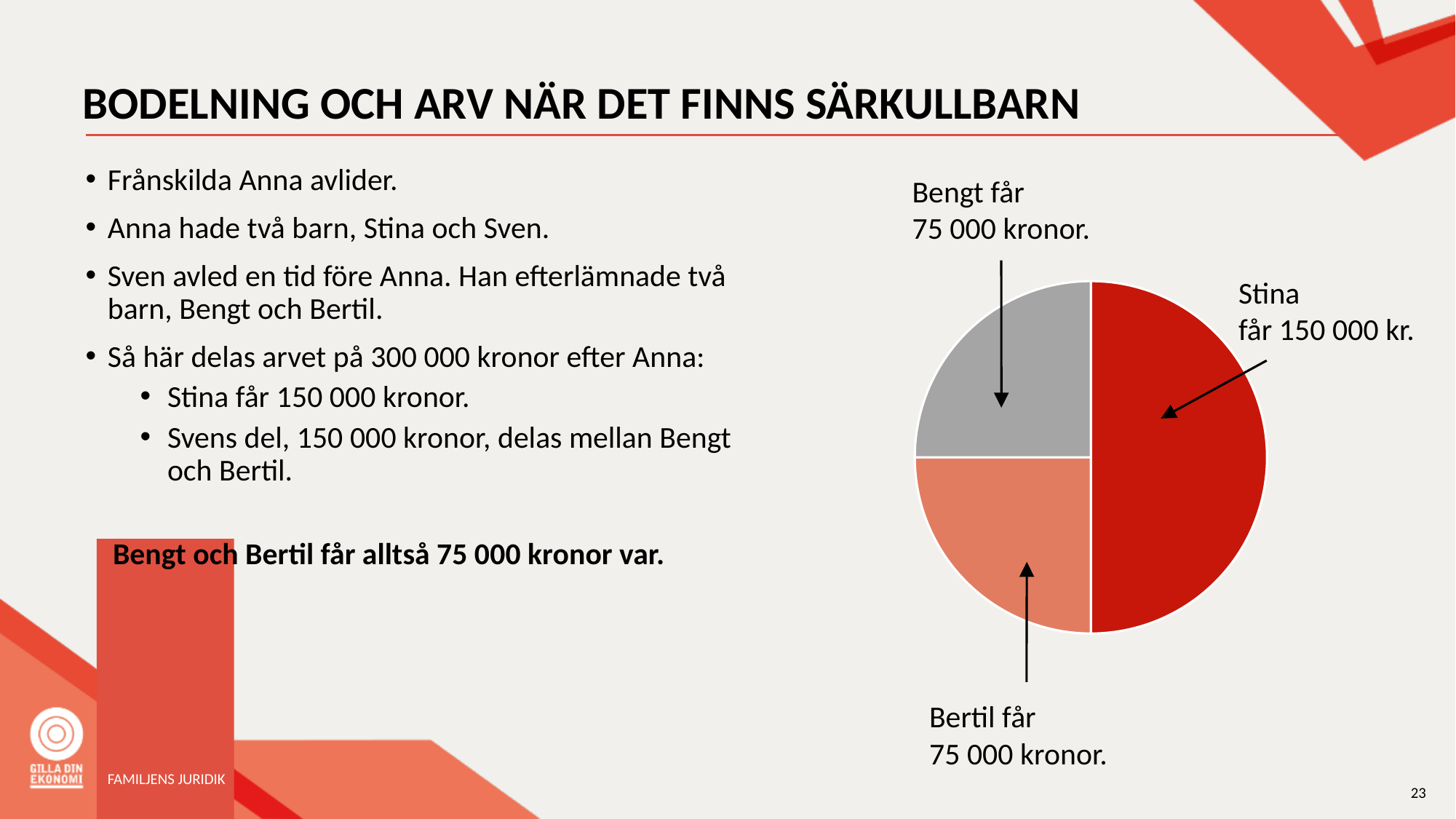
What share of the pie chart does Stina's slice represent? 50% What kind of chart is shown on the slide? pie chart Who receives more according to the pie chart, Stina or Bertil? Stina What colour is Stina's slice in the pie chart? red How much does Stina receive according to the pie chart? 150 000 kr How much does Bertil receive according to the pie chart? 75 000 kronor How much does Bengt receive according to the pie chart? 75 000 kronor What share of the pie chart does Bengt's slice represent? 25% What is the total of all slices in the pie chart? 300 000 kronor Which person receives the largest share of the pie chart? Stina What is the difference between Stina's amount and Bengt's amount in the pie chart? 75 000 kronor How many slices does the pie chart have? 3